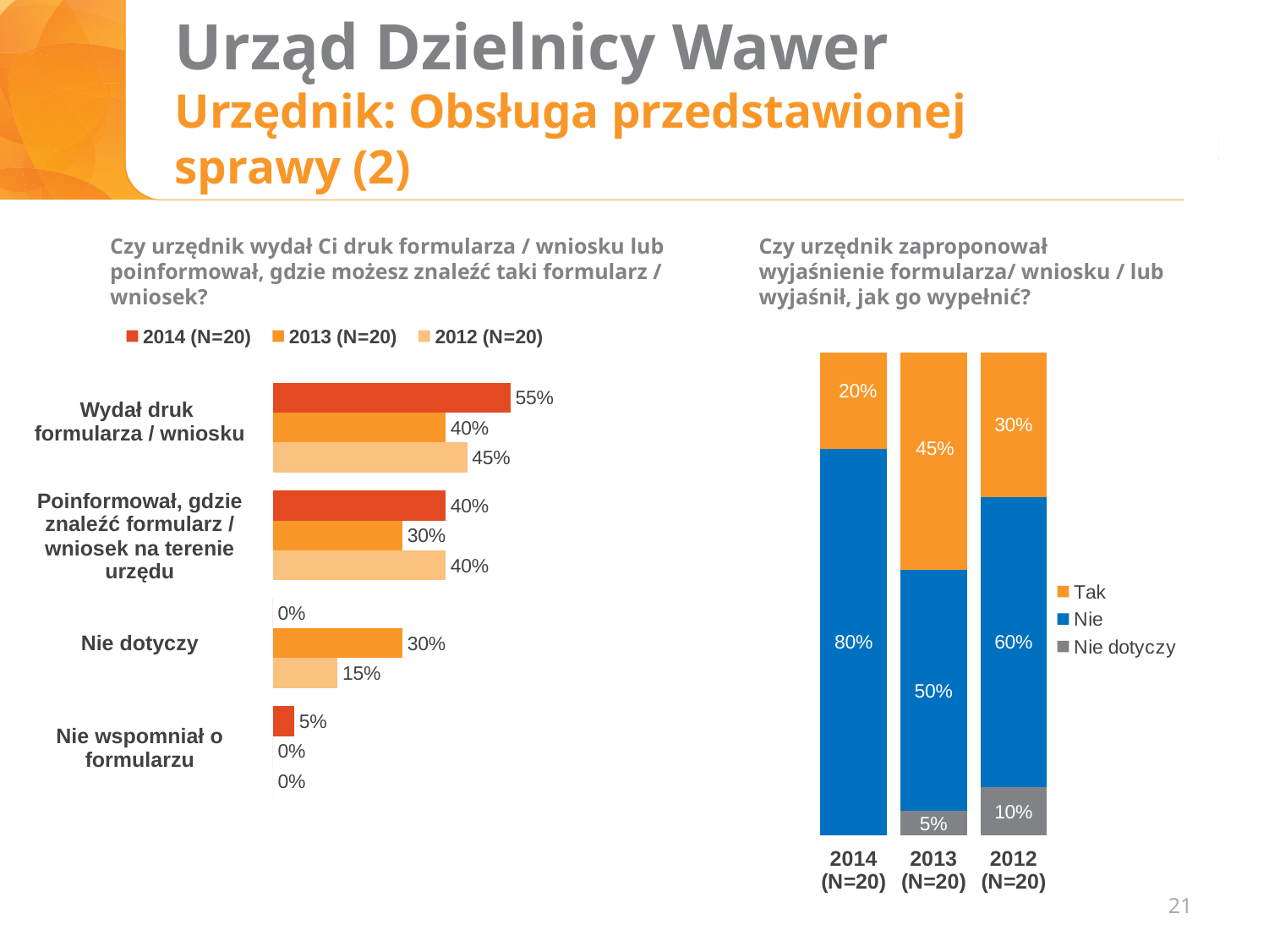
In the right chart, what is the "Nie" value for 2014 (N=20)? 80% In the left chart, what is the 2014 (N=20) value for "Wydał druk formularza / wniosku"? 55% In the left chart, what is the difference between the 2014 and 2013 values for "Wydał druk formularza / wniosku"? 15% In the right chart, which year has the highest "Nie dotyczy" value? 2012 (N=20) What kind of chart is the chart on the right? Stacked bar chart In the left chart, what is the 2012 (N=20) value for "Poinformował, gdzie znaleźć formularz / wniosek na terenie urzędu"? 40% In the left chart, which category has the highest 2014 (N=20) value? Wydał druk formularza / wniosku In the right chart, what is the "Tak" value for 2013 (N=20)? 45% In the right chart, is the "Tak" value for 2014 (N=20) larger or smaller than the "Tak" value for 2012 (N=20)? Smaller In the left chart, how many categories are shown? 4 In the left chart, what is the 2013 (N=20) value for "Nie dotyczy"? 30% In the left chart, how many series does the legend list? 3